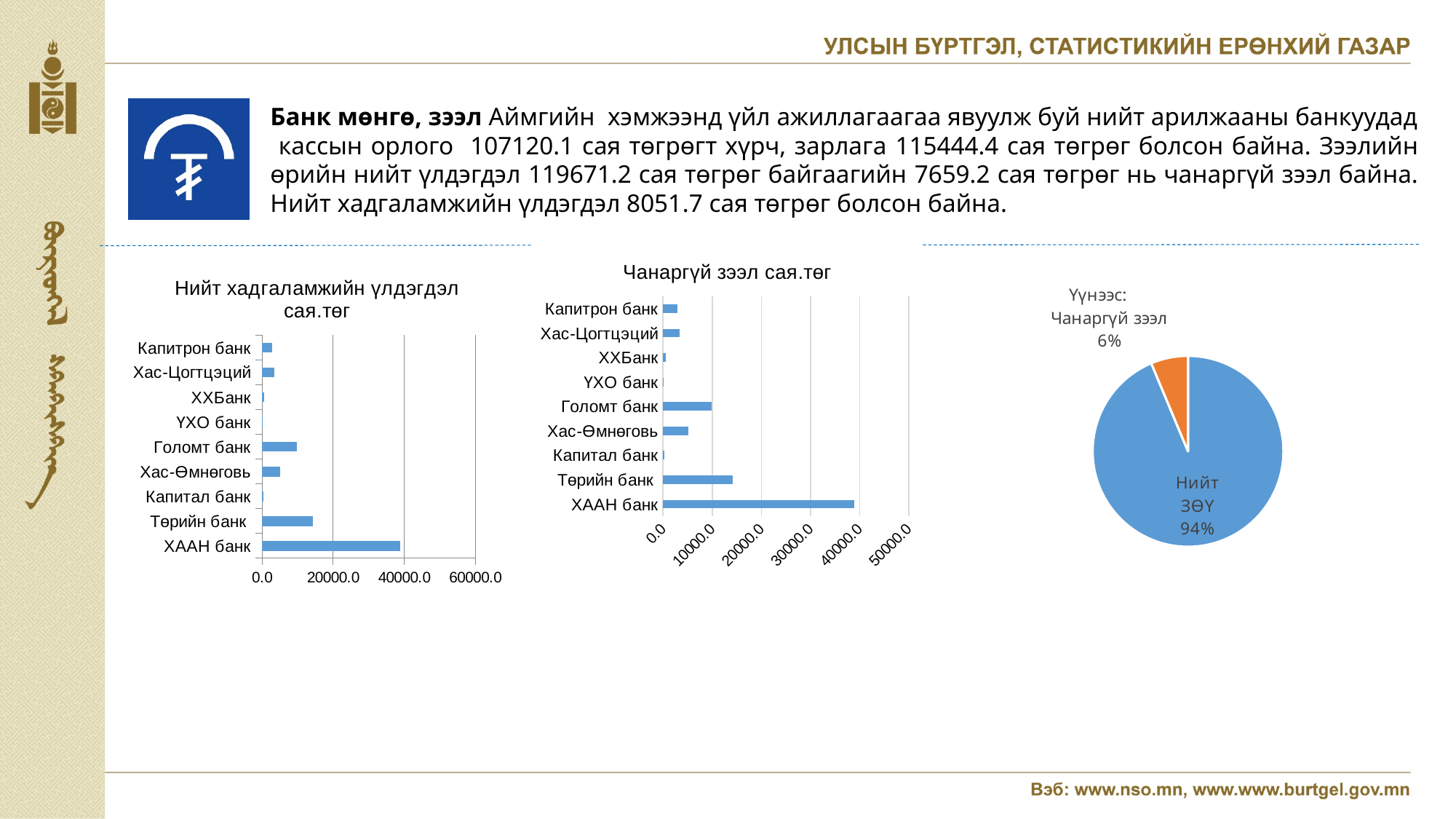
What kind of chart is the left chart titled 'Нийт хадгаламжийн үлдэгдэл сая.төг'? bar chart In the pie chart on the right, what share does 'Нийт ЗӨҮ' have? 94% In the pie chart on the right, what share does 'Чанаргүй зээл' have? 6% In the left chart 'Нийт хадгаламжийн үлдэгдэл сая.төг', which is larger: Төрийн банк or Голомт банк? Төрийн банк In the middle chart 'Чанаргүй зээл сая.төг', which bank has the highest value? ХААН банк In the middle chart 'Чанаргүй зээл сая.төг', is the value for Төрийн банк greater or less than 10000.0? greater In the left chart 'Нийт хадгаламжийн үлдэгдэл сая.төг', is the value for ХААН банк greater or less than 20000.0? greater How many banks are listed in the left chart 'Нийт хадгаламжийн үлдэгдэл сая.төг'? 9 In the middle chart 'Чанаргүй зээл сая.төг', which is larger: Хас-Өмнөговь or Хас-Цогтцэций? Хас-Өмнөговь In the middle chart 'Чанаргүй зээл сая.төг', is the value for Хас-Өмнөговь greater or less than 10000.0? less In the left chart 'Нийт хадгаламжийн үлдэгдэл сая.төг', which bank has the highest value? ХААН банк In the left chart 'Нийт хадгаламжийн үлдэгдэл сая.төг', which bank has the lowest value? ҮХО банк